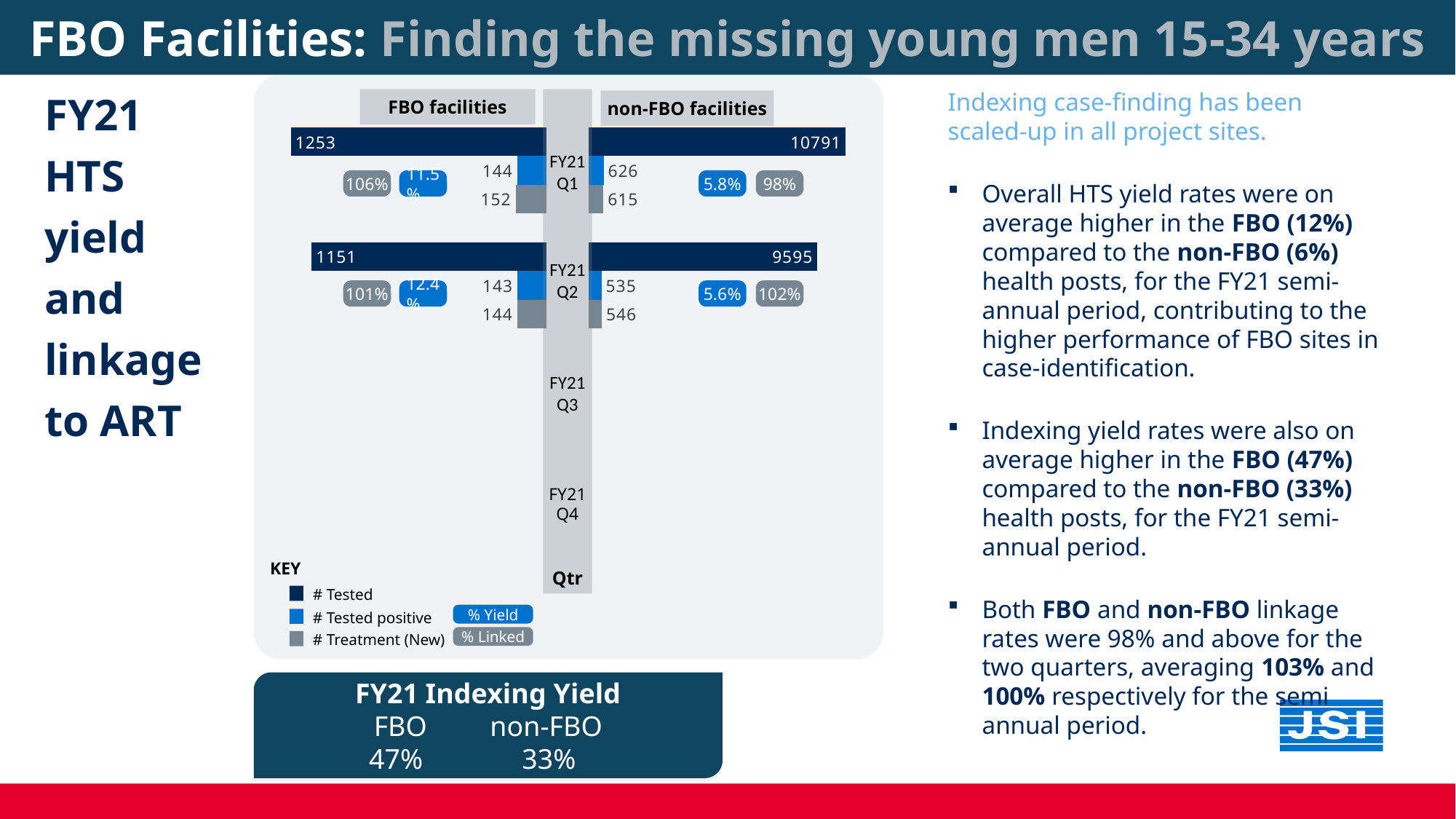
What is the number tested at non-FBO facilities in FY21 Q2? 9595 What is the # Treatment (New) value for FBO facilities in FY21 Q2? 144 What kind of chart is shown on the slide? Bar chart What is the % Linked for non-FBO facilities in FY21 Q1? 98% What is the number tested at FBO facilities in FY21 Q1? 1253 Which quarter has the higher number tested at non-FBO facilities, FY21 Q1 or FY21 Q2? FY21 Q1 How many entries does the chart's key list? 5 Which has the higher % Yield in FY21 Q1, FBO facilities or non-FBO facilities? FBO facilities How many quarters are labelled on the chart's central axis? 4 What is the % Yield for FBO facilities in FY21 Q2? 12.4% How many were tested positive at non-FBO facilities in FY21 Q1? 626 What is the difference between the number tested at non-FBO facilities and FBO facilities in FY21 Q1? 9538